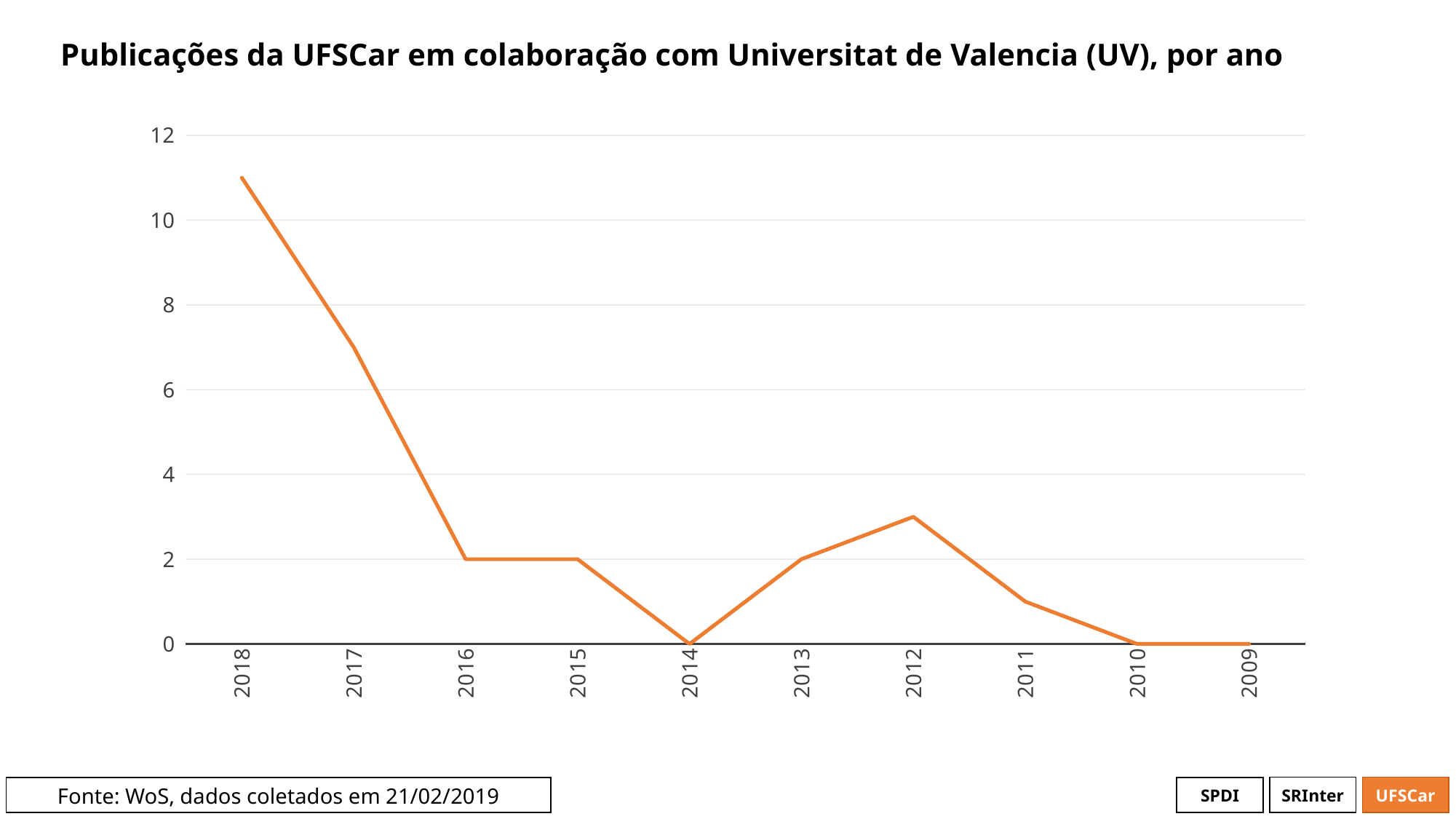
Is the value for 2018 greater or less than 10? greater Is the value for 2017 greater or less than 8? less What kind of chart is shown on the slide? line chart What is the value for 2014? 0 What is the difference between the values for 2015 and 2014? 2 What is the value for 2009? 0 What is the value for 2016? 2 What is the value for 2013? 2 Which is larger, the value for 2018 or the value for 2017? 2018 How many years are plotted on the x axis? 10 Is the value for 2012 greater or less than 2? greater Which year has the highest number of publications? 2018